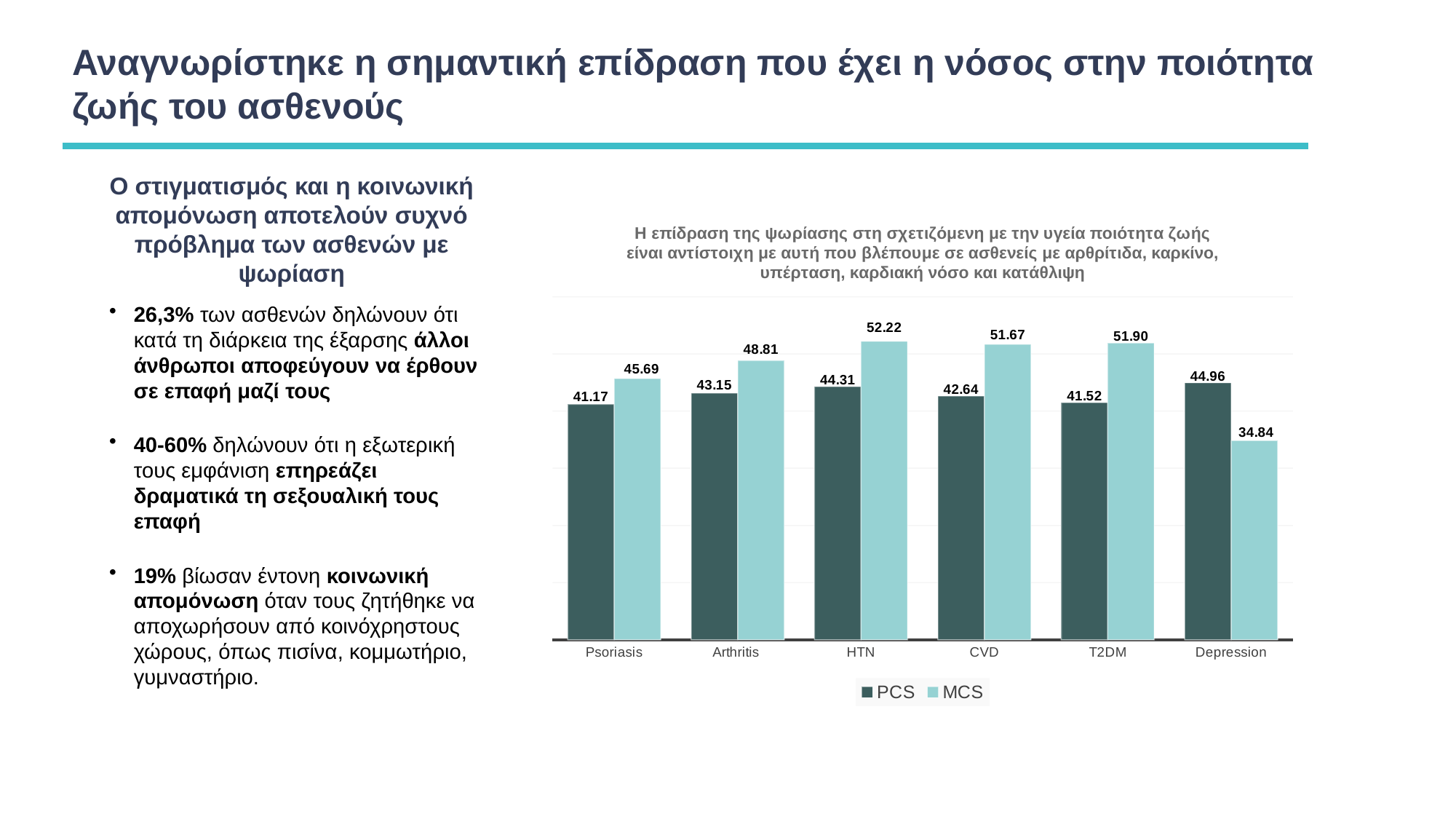
Which category has the lowest PCS value? Psoriasis What is the PCS value for T2DM? 41.52 How many series does the legend list? 2 What is the difference between the MCS and PCS values for Psoriasis? 4.52 How many categories are shown on the x axis? 6 What is the MCS value for Depression? 34.84 What kind of chart is shown on the slide? Bar chart Which is larger for Depression, the PCS value or the MCS value? PCS What is the PCS value for Psoriasis? 41.17 Which category has the highest MCS value? HTN What is the MCS value for HTN? 52.22 What are the two series named in the legend? PCS and MCS